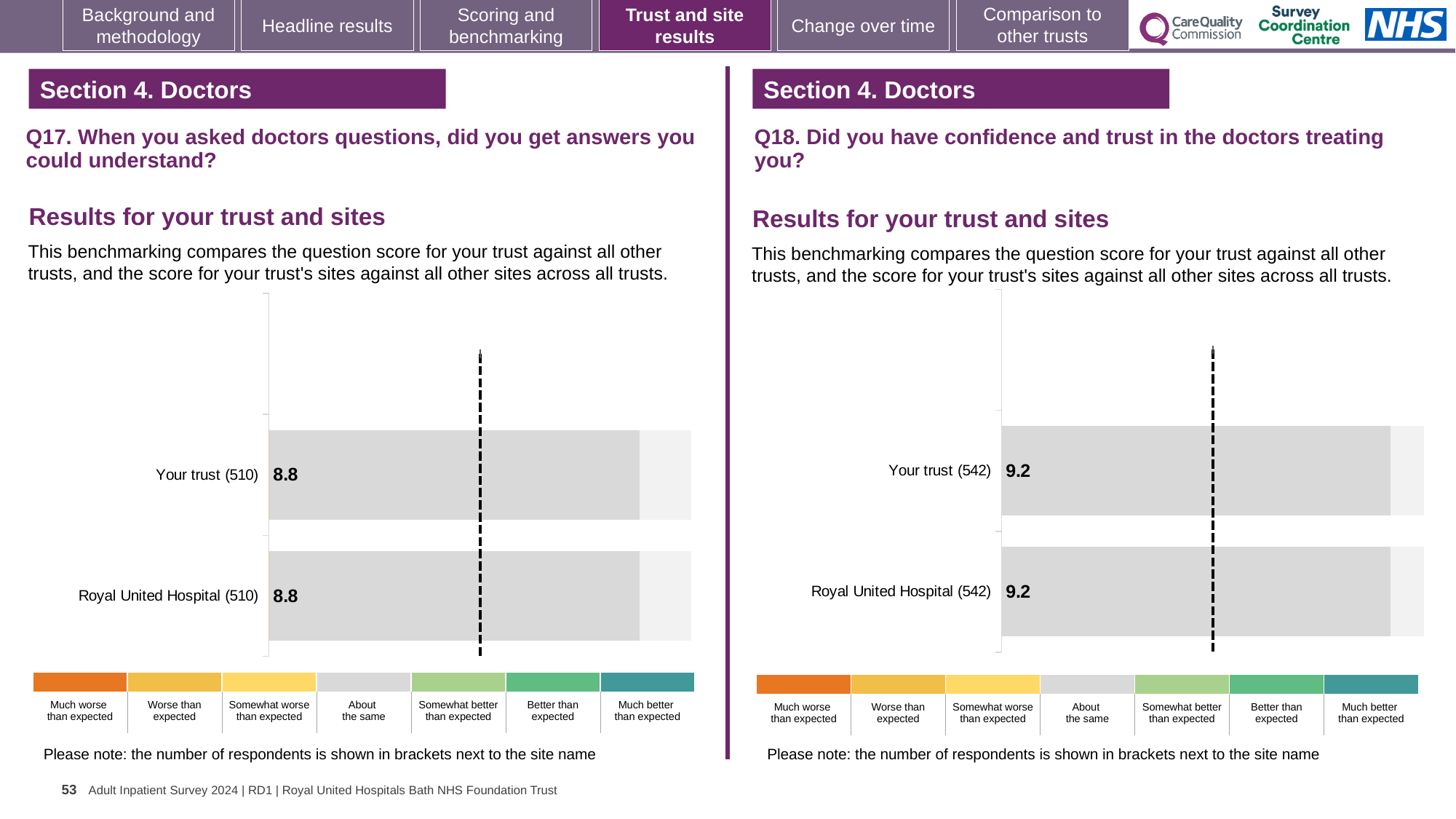
In the Q18 chart on the right, what is the score for Royal United Hospital? 9.2 Is the score for Your trust in the Q18 chart on the right larger or smaller than the score for Your trust in the Q17 chart on the left? Larger In the Q17 chart on the left, how many respondents are shown in brackets for Your trust? 510 In the Q18 chart on the right, what is the score for Your trust? 9.2 In the Q17 chart on the left, what is the difference between the score for Your trust and the score for Royal United Hospital? 0 What kind of chart is the Q17 chart on the left? Bar chart How many bars are plotted in the Q17 chart on the left? 2 In the Q18 chart on the right, what is the difference between the score for Your trust and the score for Royal United Hospital? 0 In the Q18 chart on the right, how many respondents are shown in brackets for Royal United Hospital? 542 How many bars are plotted in the Q18 chart on the right? 2 In the Q17 chart on the left, what is the score for Royal United Hospital? 8.8 In the Q17 chart on the left, what is the score for Your trust? 8.8